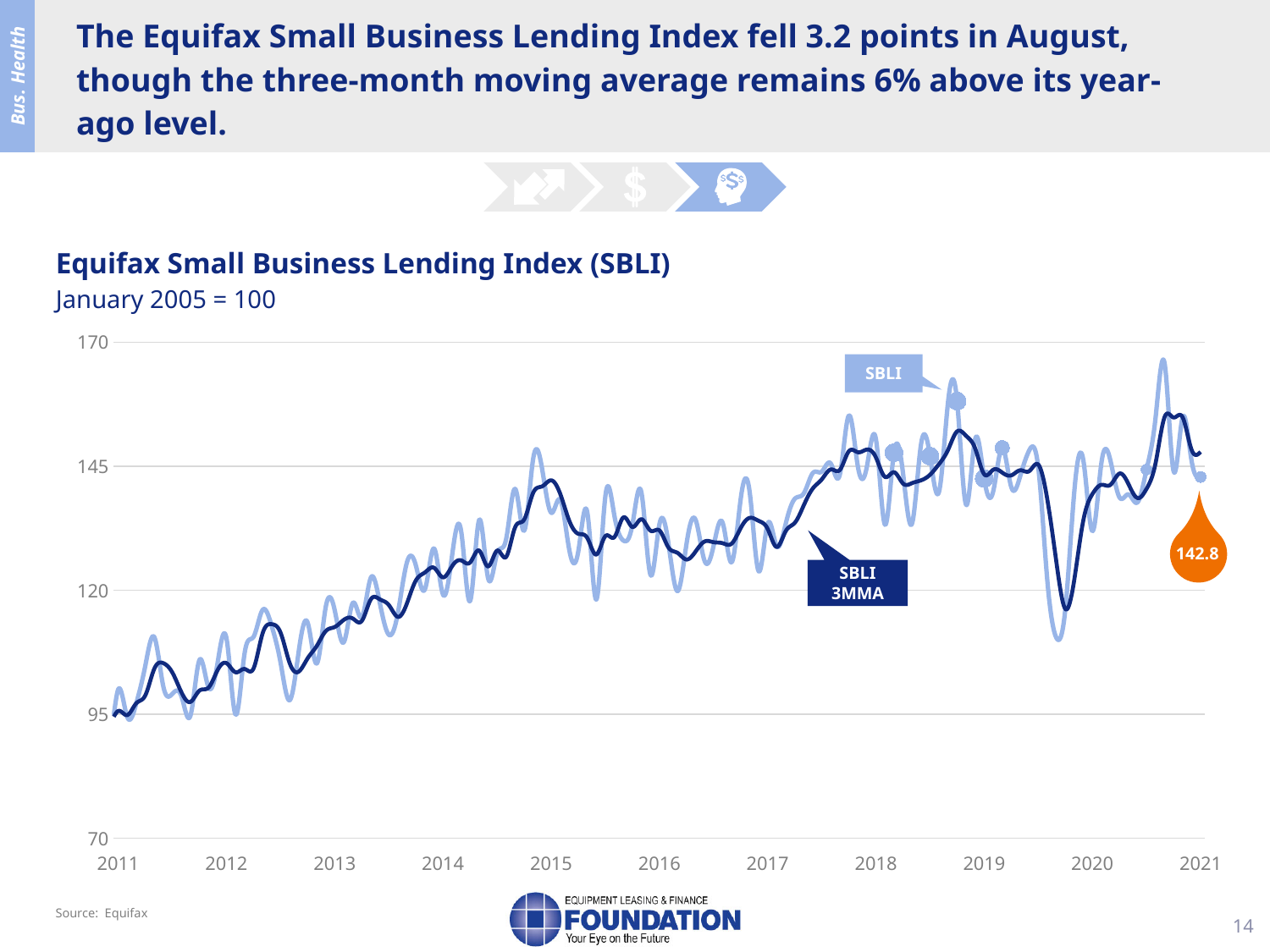
What base period is the index set to 100, according to the chart subtitle? January 2005 = 100 Is the latest SBLI value of 142.8 greater or less than 145? less What is the title of the chart? Equifax Small Business Lending Index (SBLI) Overall, does the SBLI rise or fall from 2011 to 2021? Rise What type of chart is shown on the slide? Line chart In which year does the SBLI series reach its lowest point? 2011 What is the latest SBLI value labeled on the chart? 142.8 In which year does the SBLI series reach its highest point? 2021 Is the SBLI value at the start of 2011 greater or less than 120? less How many data series are plotted on the chart? 2 Which is larger: the SBLI value at the start of 2011 or the SBLI value in 2021? 2021